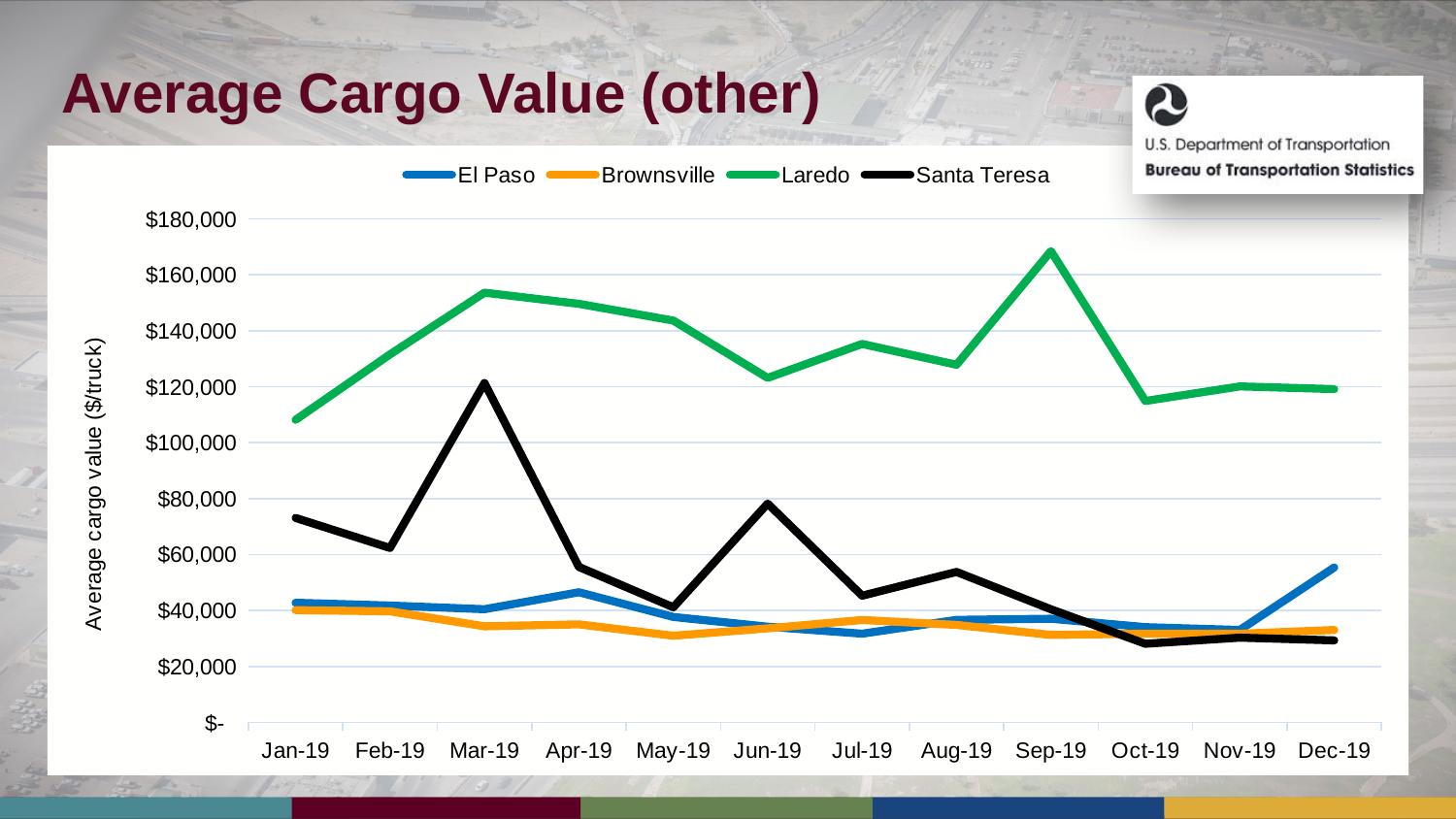
Does the Laredo line rise or fall from Sep-19 to Oct-19? Fall How many series does the legend list? 4 What is the label on the y axis? Average cargo value ($/truck) In which month does Santa Teresa reach its highest value? Mar-19 Which series has the highest average cargo value across all months? Laredo What kind of chart is shown on the slide? Line chart In which month does Laredo reach its highest value? Sep-19 Which is larger in Mar-19, the value for Santa Teresa or the value for El Paso? Santa Teresa How many months are plotted along the x axis? 12 Is the value for Santa Teresa in Mar-19 greater or less than $100,000? greater Is the value for Brownsville in May-19 greater or less than $40,000? less Is the value for Laredo in Sep-19 greater or less than $160,000? greater